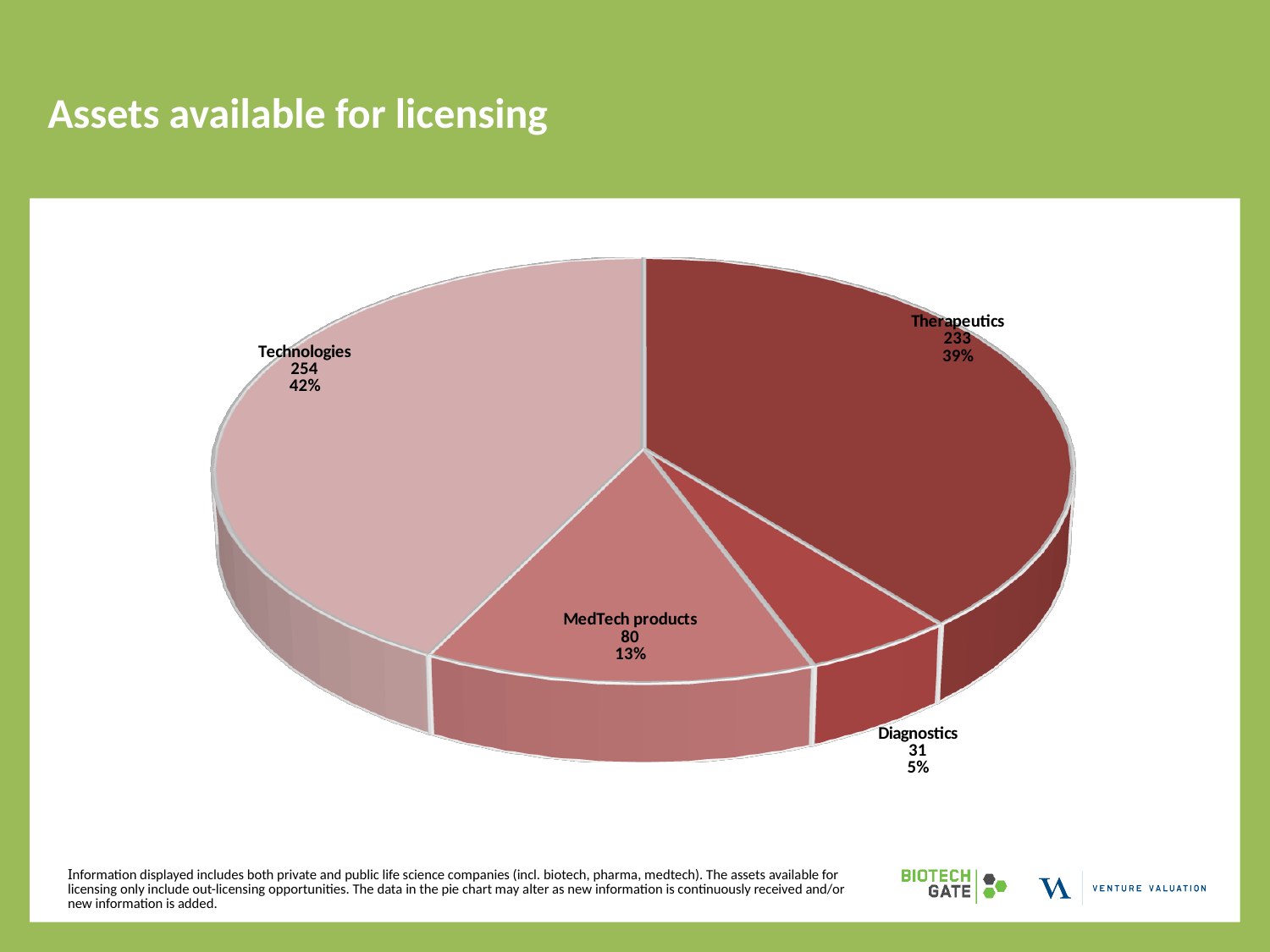
What kind of chart is shown on the slide? pie chart What is the difference between the number of assets for Technologies and Therapeutics? 21 Which has more assets, MedTech products or Diagnostics? MedTech products Which category has the largest number of assets? Technologies What percentage share does Therapeutics have? 39% How many assets are listed for Technologies? 254 What percentage share does Diagnostics have? 5% How many categories are shown in the pie chart? 4 What is the title of the slide? Assets available for licensing How many assets are listed for MedTech products? 80 Which category has the smallest number of assets? Diagnostics What is the difference between the number of assets for MedTech products and Diagnostics? 49